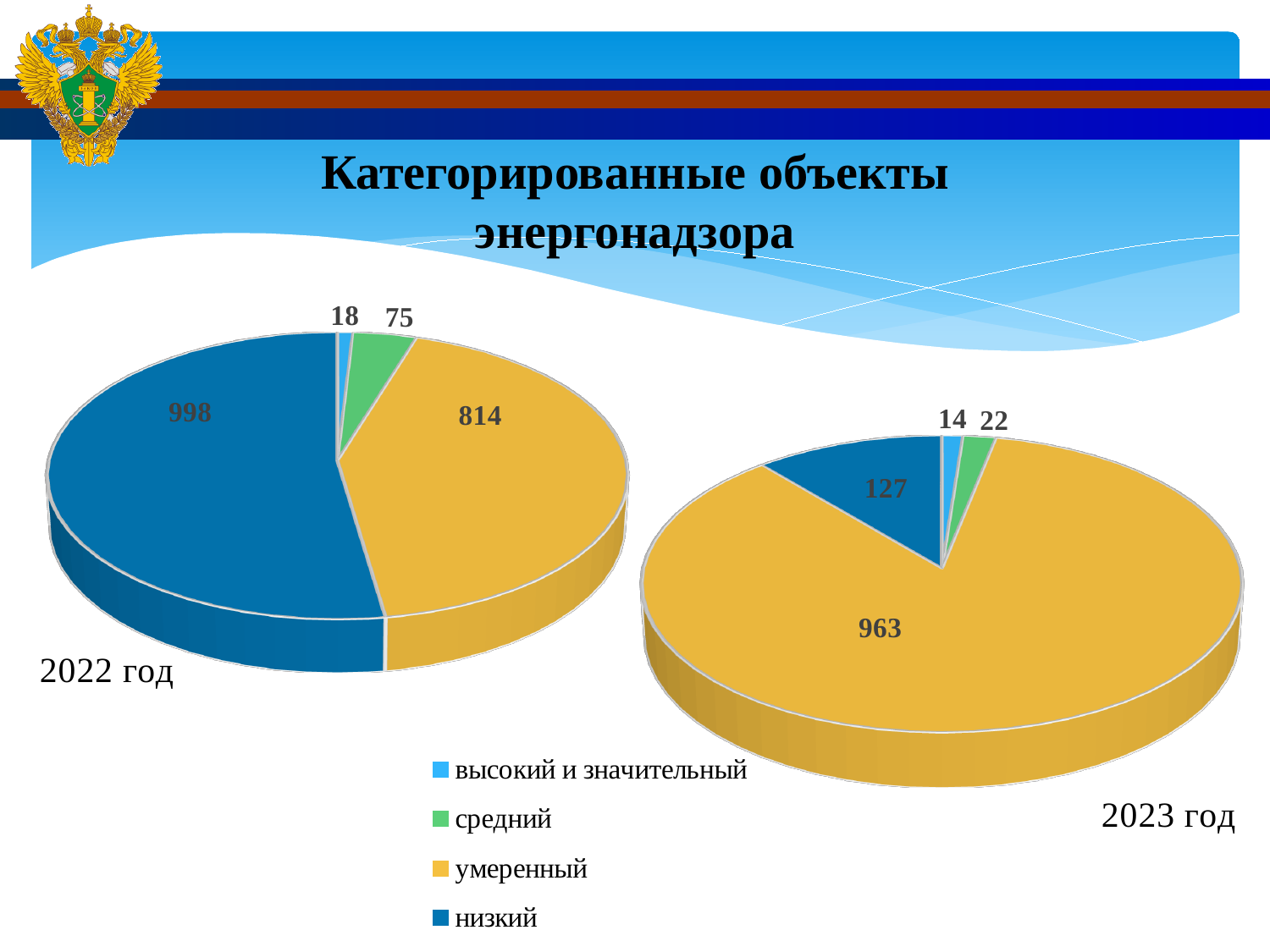
On the 2022 год pie chart, which category has the largest slice? низкий Which colour represents средний in the legend? Green On the 2022 год pie chart, what is the value for средний? 75 What is the total of all slices on the 2023 год pie chart? 1126 What is the difference between the низкий values on the 2022 год and 2023 год pie charts? 871 On the 2023 год pie chart, which category has the smallest slice? высокий и значительный On the 2023 год pie chart, what is the value for высокий и значительный? 14 On the 2023 год pie chart, what is the value for умеренный? 963 On the 2022 год pie chart, which is larger: умеренный or низкий? низкий What type of chart is used on this slide? Pie chart On the 2022 год pie chart, what is the value for низкий? 998 How many slices does the 2023 год pie chart have? 4